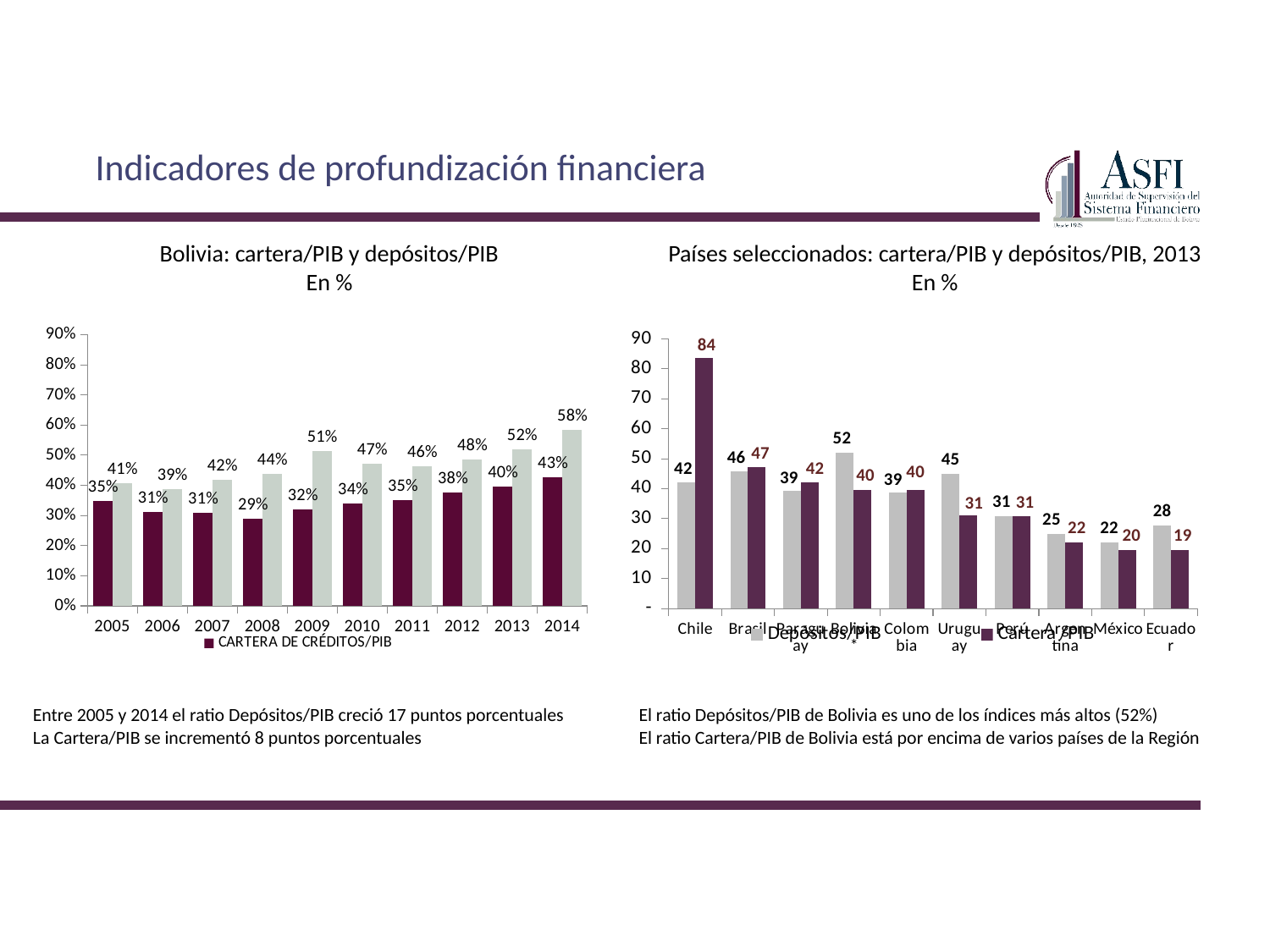
In the chart 'Países seleccionados: cartera/PIB y depósitos/PIB, 2013', which country has the lowest Cartera/PIB value? Ecuador In the chart 'Bolivia: cartera/PIB y depósitos/PIB', what is the difference between the depósitos/PIB value in 2014 and in 2005? 17 percentage points In the chart 'Bolivia: cartera/PIB y depósitos/PIB', what is the value of CARTERA DE CRÉDITOS/PIB for 2014? 43% In the chart 'Bolivia: cartera/PIB y depósitos/PIB', does the CARTERA DE CRÉDITOS/PIB value rise or fall from 2008 to 2014? rise In the chart 'Bolivia: cartera/PIB y depósitos/PIB', what is the value of the lighter (depósitos) bar for 2009? 51% In the chart 'Países seleccionados: cartera/PIB y depósitos/PIB, 2013', which is larger for Uruguay: Depósitos/PIB or Cartera/PIB? Depósitos/PIB In the chart 'Bolivia: cartera/PIB y depósitos/PIB', which year has the highest depósitos/PIB value? 2014 In the chart 'Bolivia: cartera/PIB y depósitos/PIB', how many years are shown on the x axis? 10 In the chart 'Países seleccionados: cartera/PIB y depósitos/PIB, 2013', what is the Cartera/PIB value for Chile? 84 In the chart 'Países seleccionados: cartera/PIB y depósitos/PIB, 2013', which country has the highest Depósitos/PIB value? Bolivia In the chart 'Bolivia: cartera/PIB y depósitos/PIB', which year has the lowest CARTERA DE CRÉDITOS/PIB value? 2008 In the chart 'Países seleccionados: cartera/PIB y depósitos/PIB, 2013', how many series does the legend list? 2